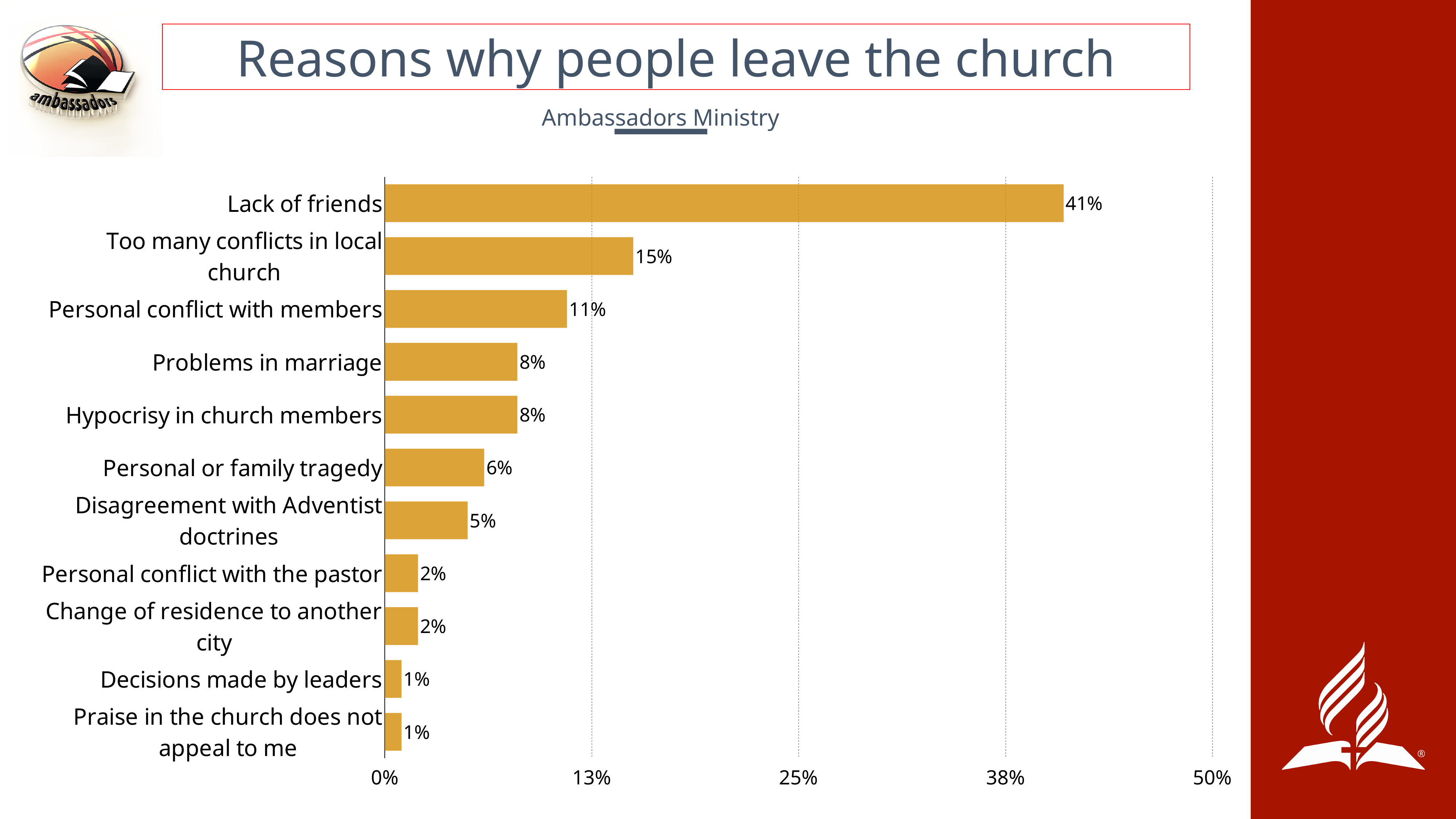
Which is larger, "Personal or family tragedy" or "Disagreement with Adventist doctrines"? Personal or family tragedy What kind of chart is shown on the slide? Bar chart Which reason has the highest percentage? Lack of friends Is the value for "Lack of friends" greater or less than 38%? greater How many reasons (categories) are shown in the chart? 11 What is the difference between "Lack of friends" and "Too many conflicts in local church"? 26% What percentage is shown for "Lack of friends"? 41% What percentage is given for "Personal conflict with members"? 11% What is the value for "Disagreement with Adventist doctrines"? 5% What is the value for "Too many conflicts in local church"? 15% What is the difference between "Personal conflict with members" and "Personal or family tragedy"? 5% What is the title of the slide containing the chart? Reasons why people leave the church